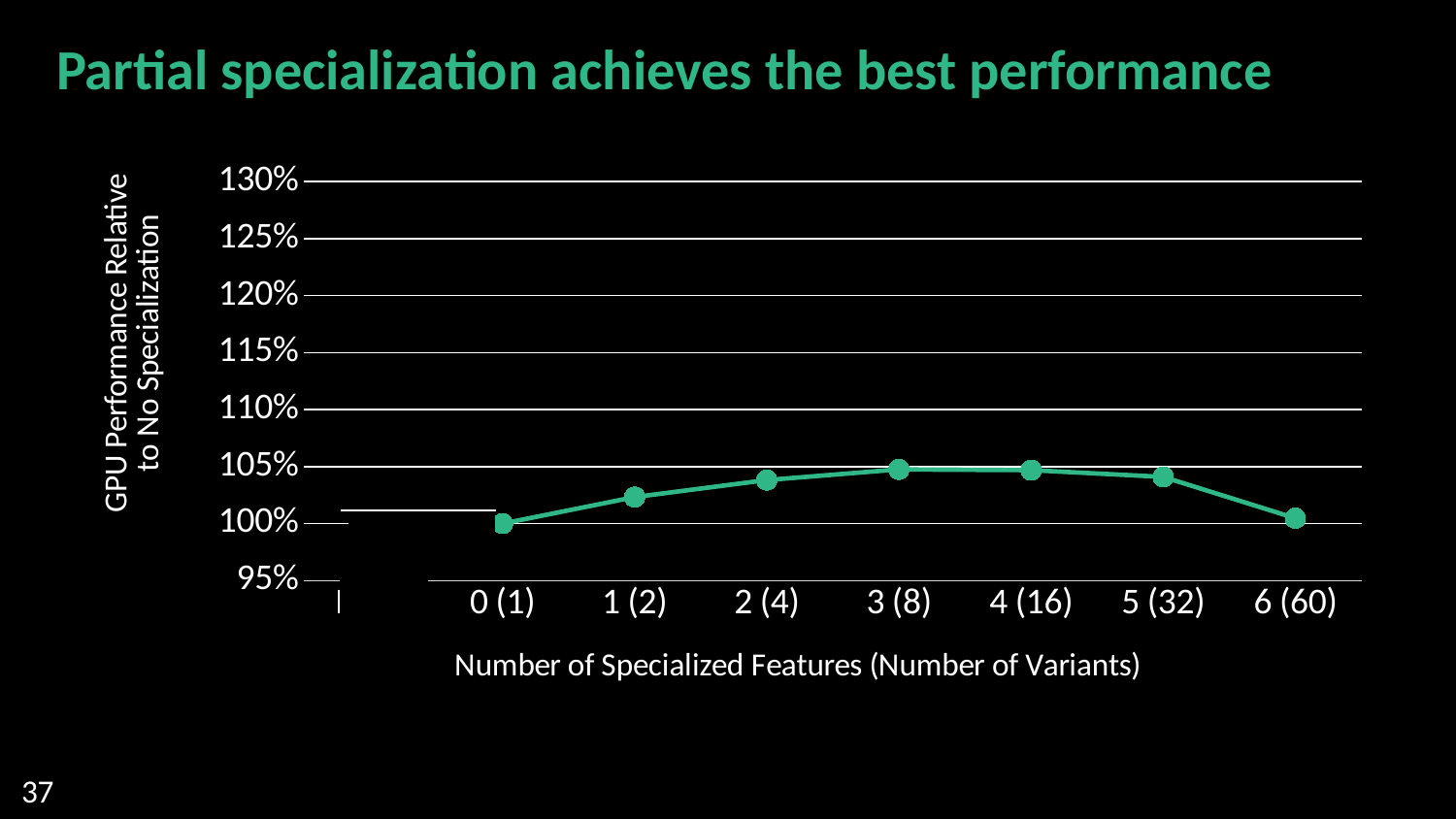
Which has the larger value, 1 (2) or 2 (4)? 2 (4) Which has the larger value, 5 (32) or 6 (60)? 5 (32) What is the label of the x axis? Number of Specialized Features (Number of Variants) Is the value for 3 (8) greater or less than 110%? less How many data points are plotted on the line? 7 What kind of chart is shown on the slide? line chart Is the value for 6 (60) greater or less than 105%? less Is the value for 1 (2) greater or less than 100%? greater What is the title of the chart on the slide? Partial specialization achieves the best performance Which has the larger value, 0 (1) or 3 (8)? 3 (8) How does the GPU performance change as the number of specialized features increases from 0 (1) to 6 (60)? It rises, then falls